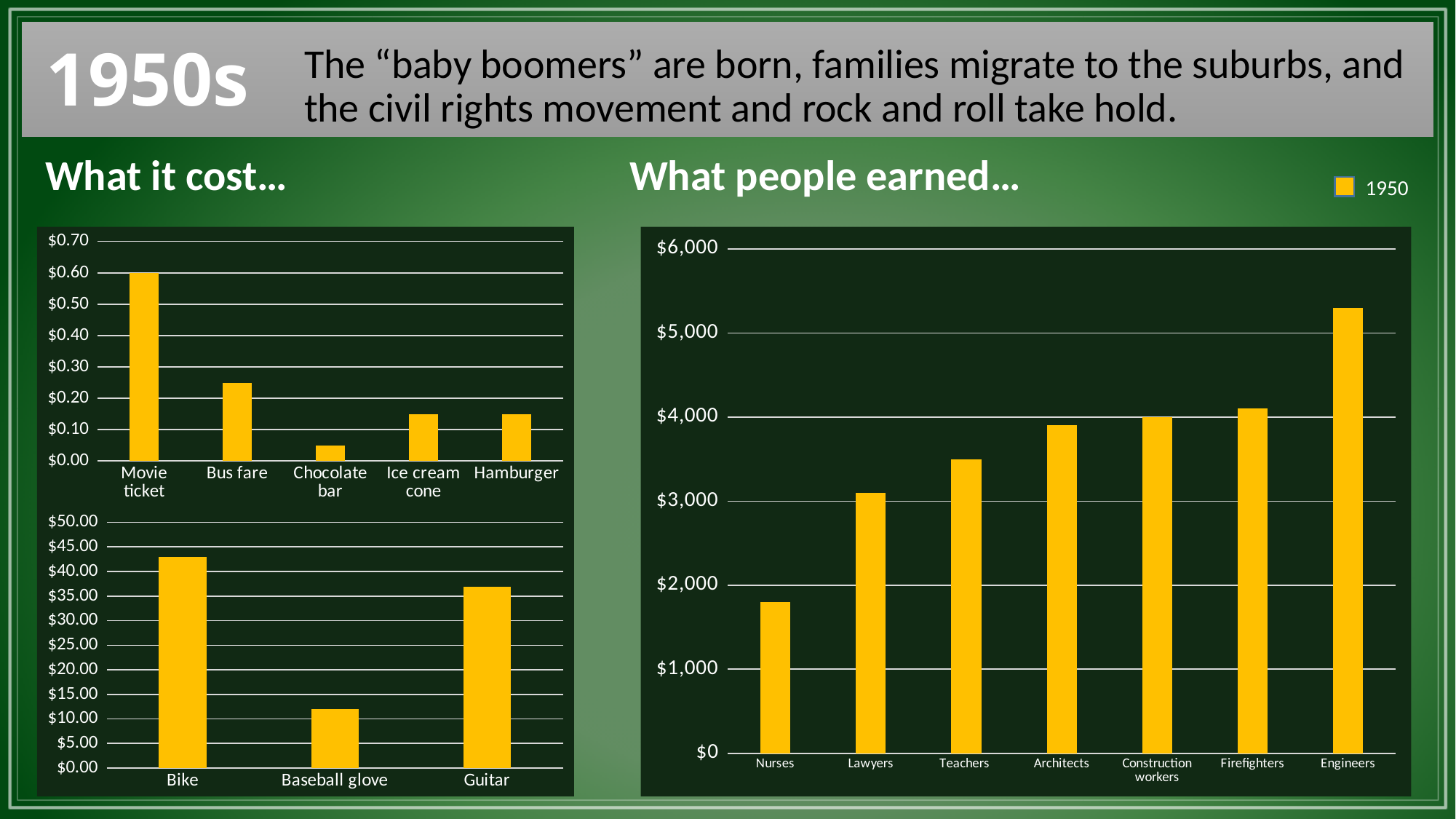
On the 'What people earned...' chart, how many occupations are shown? 7 On the top-left 'What it cost...' chart, which item is the cheapest? Chocolate bar On the bottom-left 'What it cost...' chart, is the value for Baseball glove greater or less than $15.00? less On the 'What people earned...' chart, is the value for Nurses greater or less than $2,000? less On the 'What people earned...' chart, which is larger, the value for Teachers or the value for Lawyers? Teachers On the top-left 'What it cost...' chart, which item is the most expensive? Movie ticket On the 'What people earned...' chart, which occupation has the highest earnings? Engineers On the 'What people earned...' chart, is the value for Lawyers greater or less than $3,000? greater On the bottom-left 'What it cost...' chart, which item is the most expensive? Bike On the 'What people earned...' chart, what year does the legend show? 1950 On the 'What people earned...' chart, which occupation has the lowest earnings? Nurses